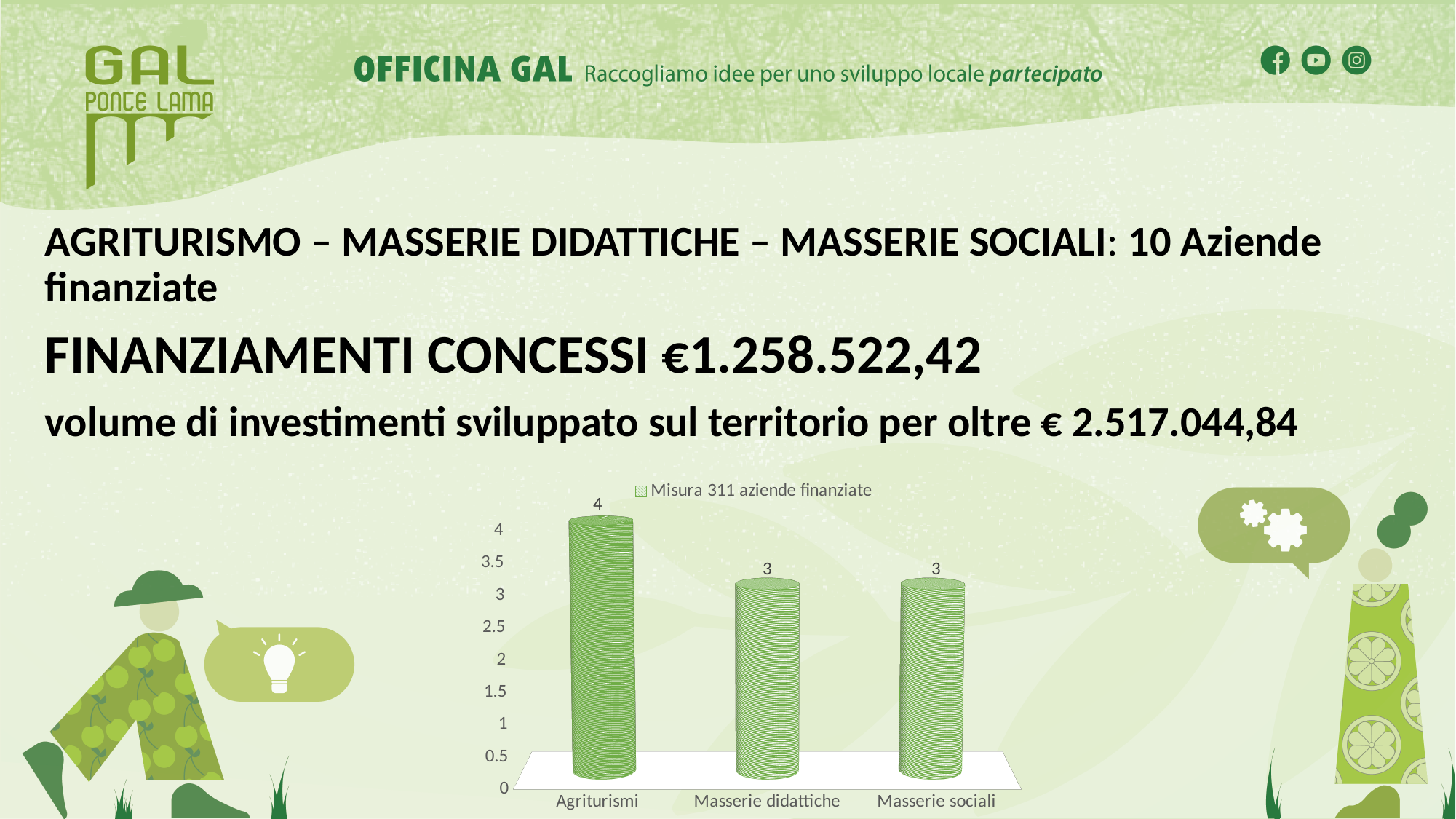
What is the value for Masserie sociali? 3 Which is larger, the value for Agriturismi or the value for Masserie sociali? Agriturismi What is the difference between the values for Agriturismi and Masserie didattiche? 1 Is the value for Agriturismi greater or less than 3.5? greater What is the series name shown in the legend? Misura 311 aziende finanziate Which category has the highest value? Agriturismi How many series does the legend list? 1 What is the value for Agriturismi? 4 What is the total of the values across all three categories? 10 What kind of chart is shown? bar chart How many categories are shown on the x axis? 3 What is the value for Masserie didattiche? 3